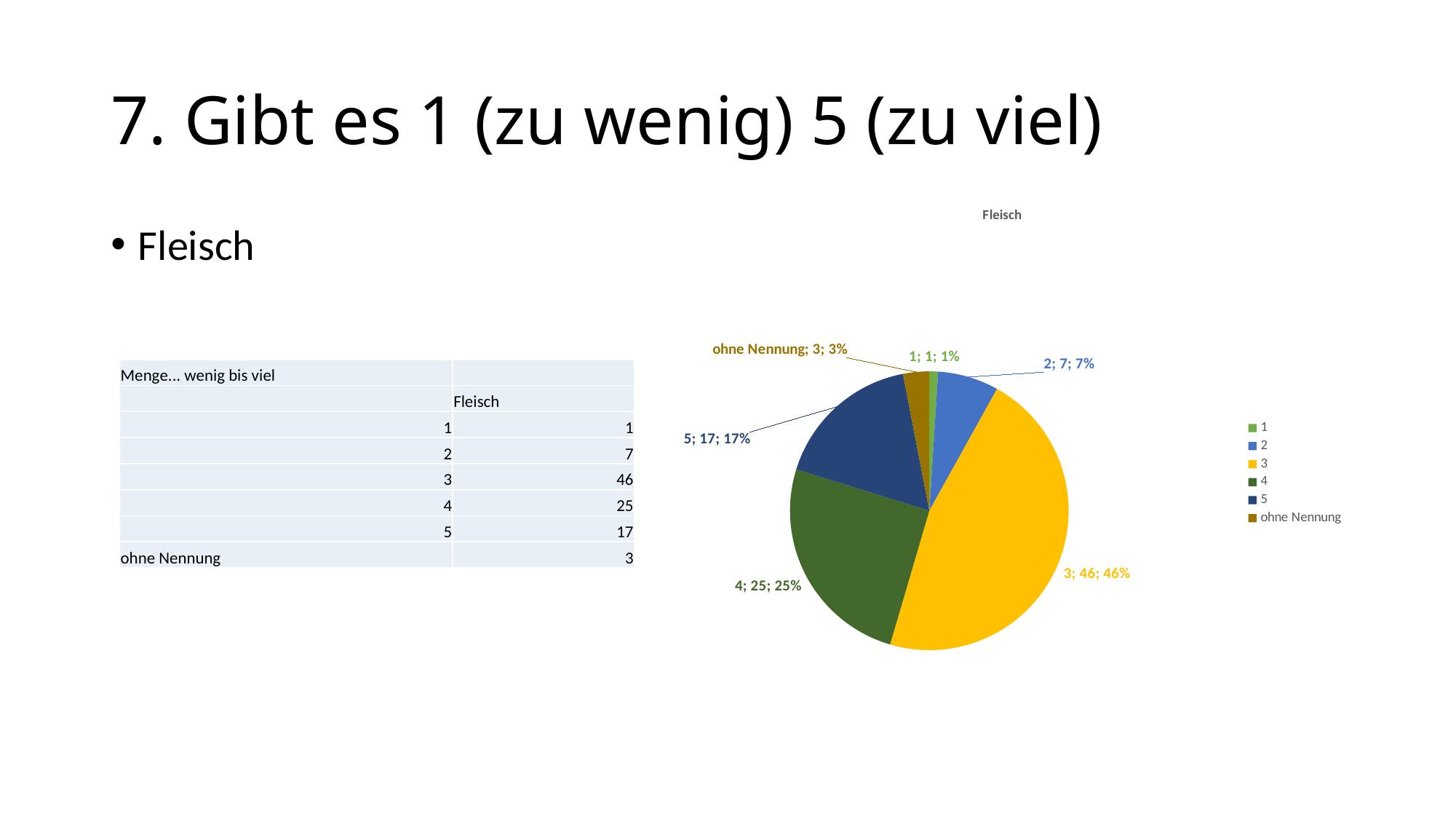
What value is shown for category 5 in the pie chart? 17 What kind of chart is shown on the slide? pie chart Which is larger in the pie chart, the value for category 2 or the value for category 5? 5 How many slices does the pie chart have? 6 Which category has the largest slice in the pie chart? 3 What value is shown for 'ohne Nennung' in the pie chart? 3 What is the difference between the values for category 3 and category 4? 21 What value is shown for category 3 in the pie chart? 46 Which category has the smallest slice in the pie chart? 1 What share of the pie does category 4 represent? 25% How many entries does the legend of the pie chart list? 6 What is the title of the pie chart? Fleisch